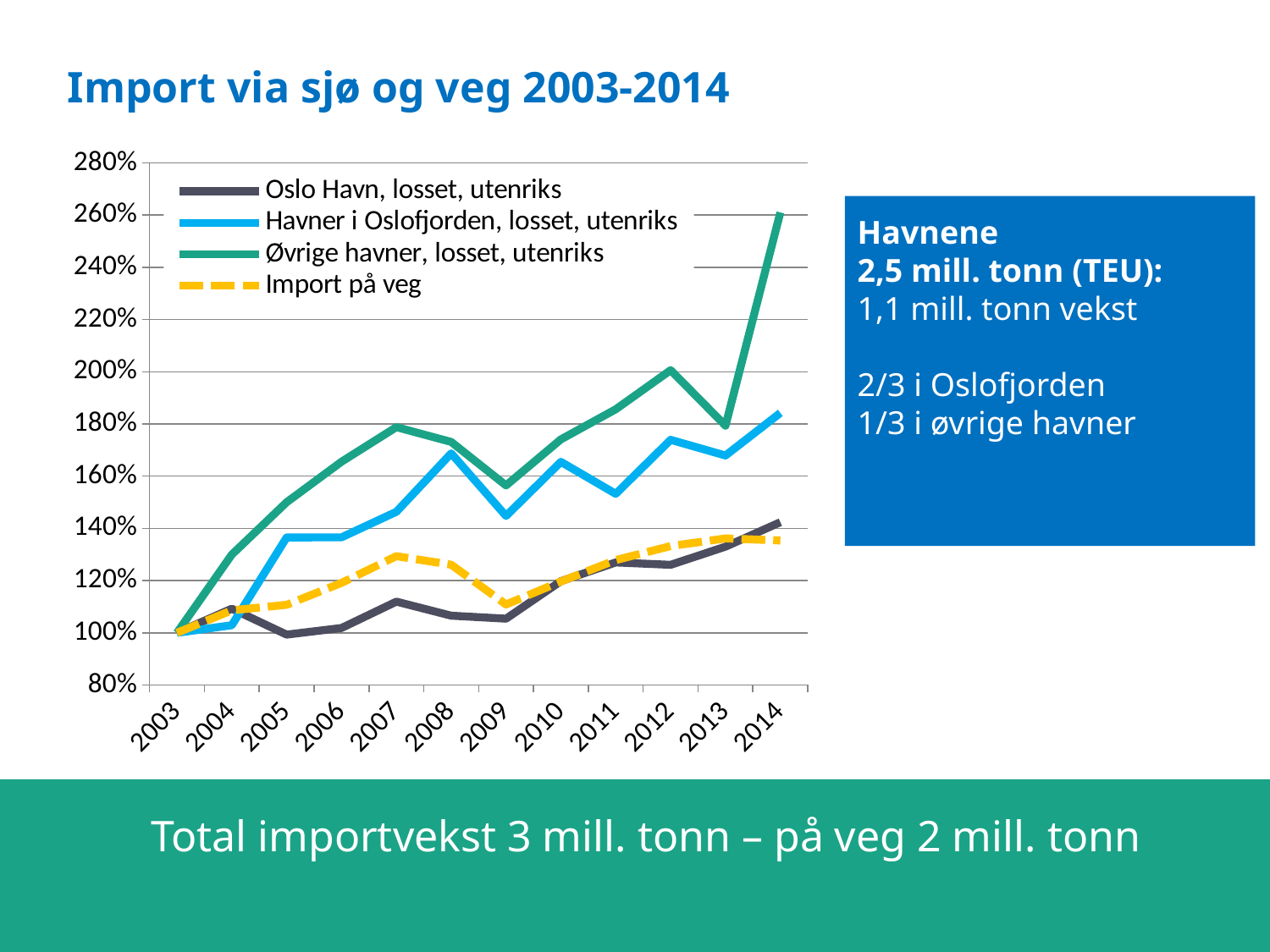
How many series does the chart legend list? 4 What kind of chart is shown on the slide? Line chart What is the title of the chart? Import via sjø og veg 2003-2014 Is the value for Oslo Havn, losset, utenriks in 2005 greater or less than 120%? less In 2008, which is higher: Havner i Oslofjorden, losset, utenriks or Oslo Havn, losset, utenriks? Havner i Oslofjorden, losset, utenriks How many years are shown along the x axis of the chart? 12 Which series has the highest value in 2014? Øvrige havner, losset, utenriks Is the value for Havner i Oslofjorden, losset, utenriks in 2014 greater or less than 160%? greater Is the value for Import på veg in 2009 greater or less than 140%? less Which series has the lowest value in 2005? Oslo Havn, losset, utenriks Does the value for Øvrige havner, losset, utenriks rise or fall from 2013 to 2014? Rise